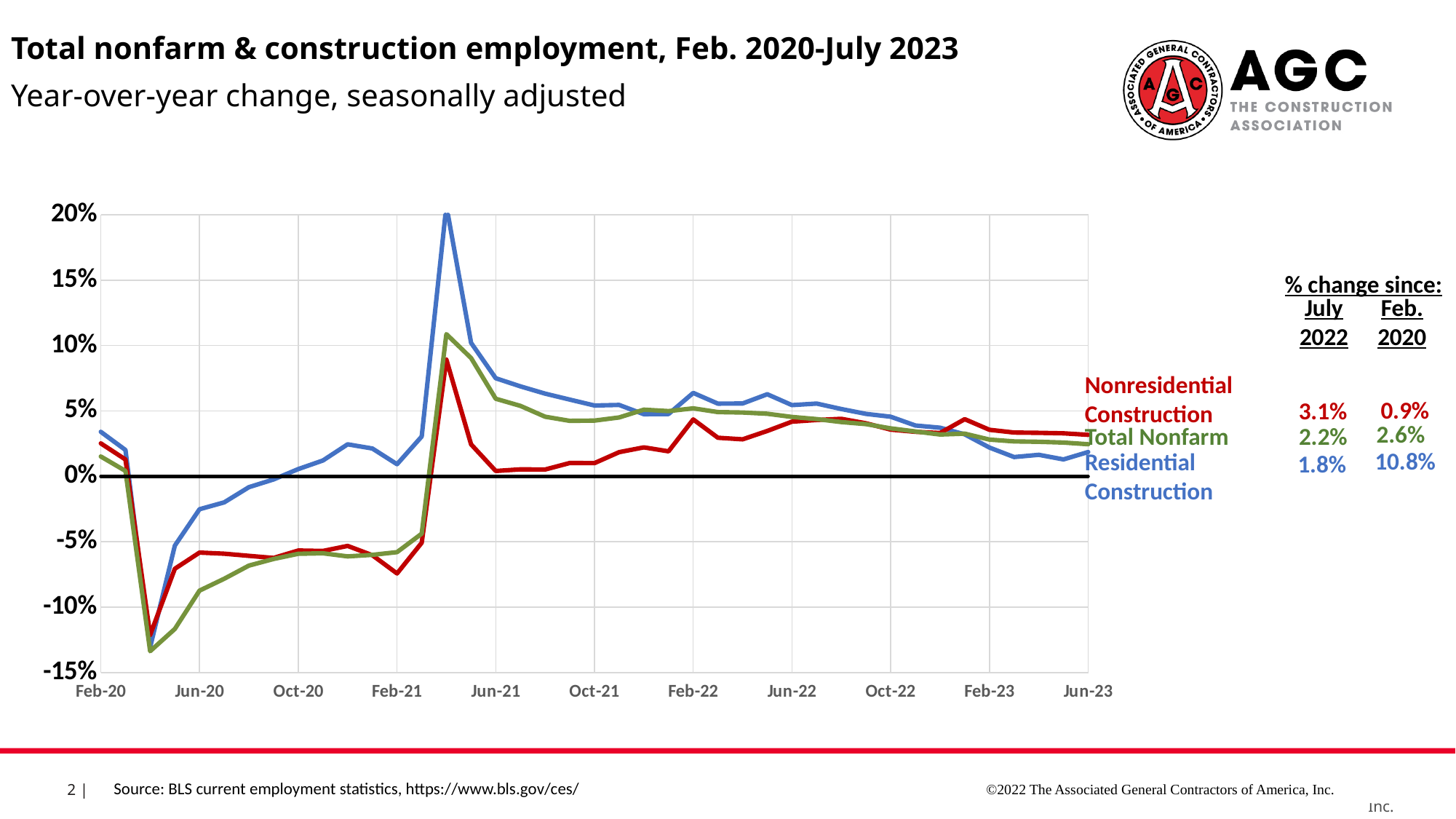
Which has the larger % change since Feb. 2020, Total Nonfarm or Nonresidential Construction? Total Nonfarm Is the lowest value of the Total Nonfarm line in 2020 greater or less than -10%? less What kind of chart is shown on the slide? Line chart How many series are plotted on the chart? 3 What is the difference between the % change since Feb. 2020 for Residential Construction and for Total Nonfarm? 8.2 percentage points Which series reaches the highest peak on the chart? Residential Construction Is the value for Nonresidential Construction at Jun-23 greater or less than 5%? less What colour is the Residential Construction line? Blue According to the table on the right, what is the % change since Feb. 2020 for Residential Construction? 10.8% Is the peak value of the Residential Construction line greater or less than 15%? greater From Jun-21 to Jun-23, does the Residential Construction line generally rise or fall? Fall According to the table on the right, what is the % change since July 2022 for Nonresidential Construction? 3.1%